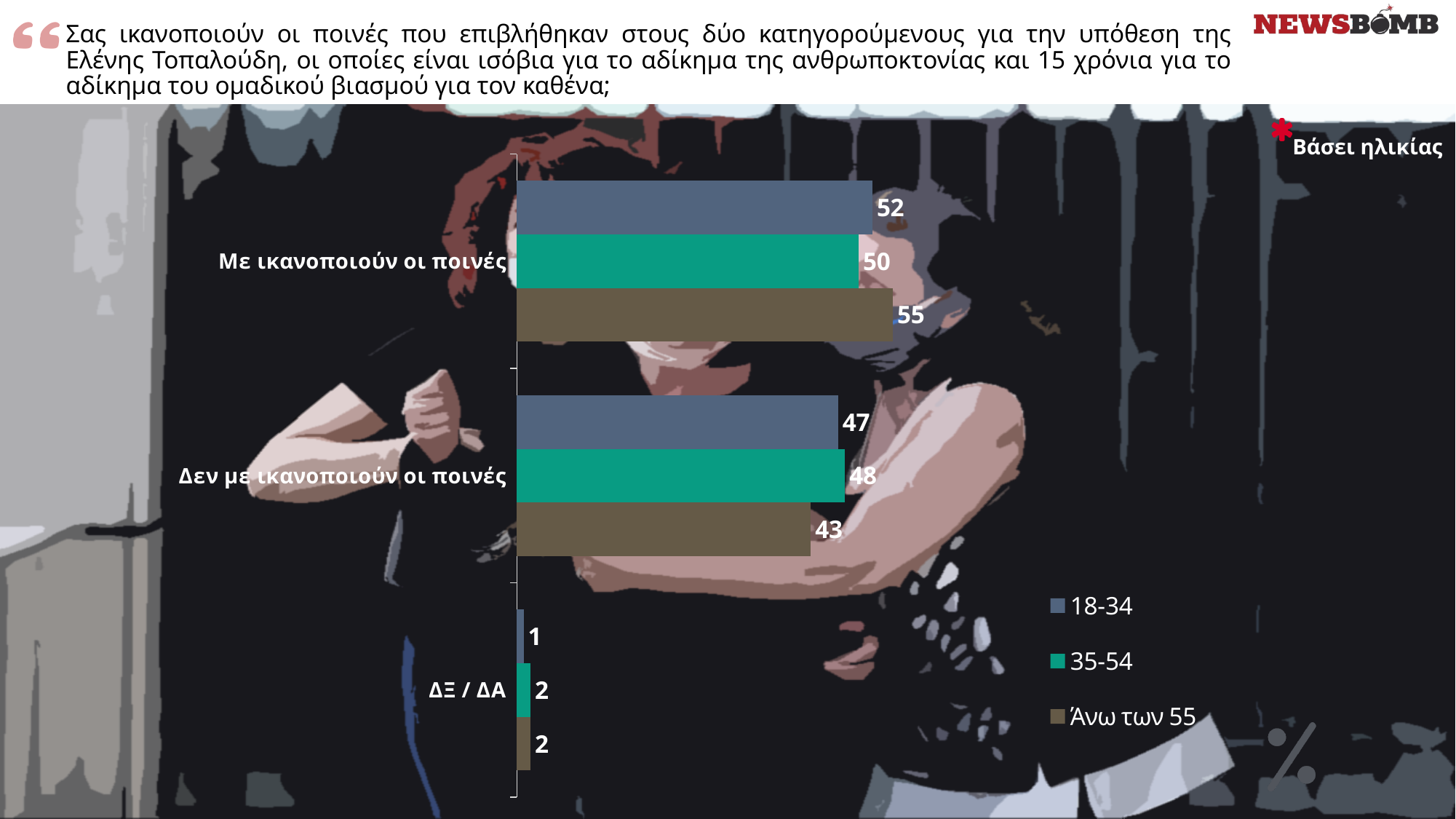
What is the value for the "Άνω των 55" series in the category "Δεν με ικανοποιούν οι ποινές"? 43 How many categories are shown on the chart? 3 What is the value for the 18-34 series in the category "Με ικανοποιούν οι ποινές"? 52 Which age group has the lowest value in the category "Δεν με ικανοποιούν οι ποινές"? Άνω των 55 Which age group has the highest value in the category "Με ικανοποιούν οι ποινές"? Άνω των 55 How many series does the legend list? 3 Which is larger for the 35-54 series: "Με ικανοποιούν οι ποινές" or "Δεν με ικανοποιούν οι ποινές"? Με ικανοποιούν οι ποινές What is the difference between the "Άνω των 55" values for "Με ικανοποιούν οι ποινές" and "Δεν με ικανοποιούν οι ποινές"? 12 What is the difference between the 18-34 and 35-54 values in the category "Με ικανοποιούν οι ποινές"? 2 What is the value for the 35-54 series in the category "ΔΞ / ΔΑ"? 2 Which series is shown in green in the legend? 35-54 What kind of chart is shown on the slide? Bar chart